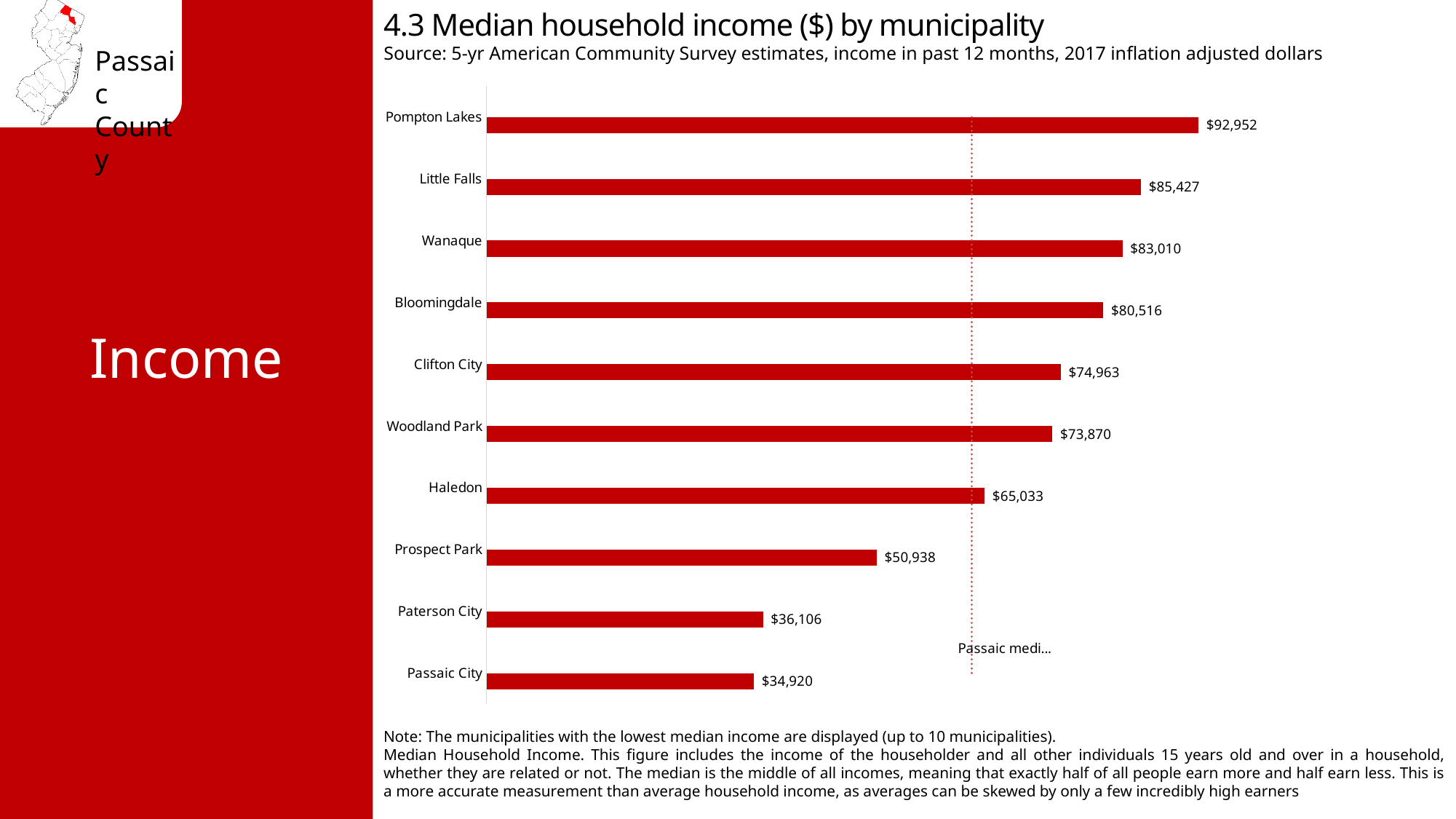
Which has a higher median household income, Bloomingdale or Haledon? Bloomingdale What is the median household income for Haledon? $65,033 Which municipality has the highest median household income on the chart? Pompton Lakes What type of chart is used to show median household income by municipality? Bar chart What is the median household income for Pompton Lakes? $92,952 Which has a higher median household income, Clifton City or Woodland Park? Clifton City What is the title of the chart? 4.3 Median household income ($) by municipality How many municipalities are shown on the chart? 10 What is the difference in median household income between Little Falls and Wanaque? $2,417 What is the median household income for Paterson City? $36,106 Which municipality has the lowest median household income on the chart? Passaic City What is the difference in median household income between Prospect Park and Passaic City? $16,018